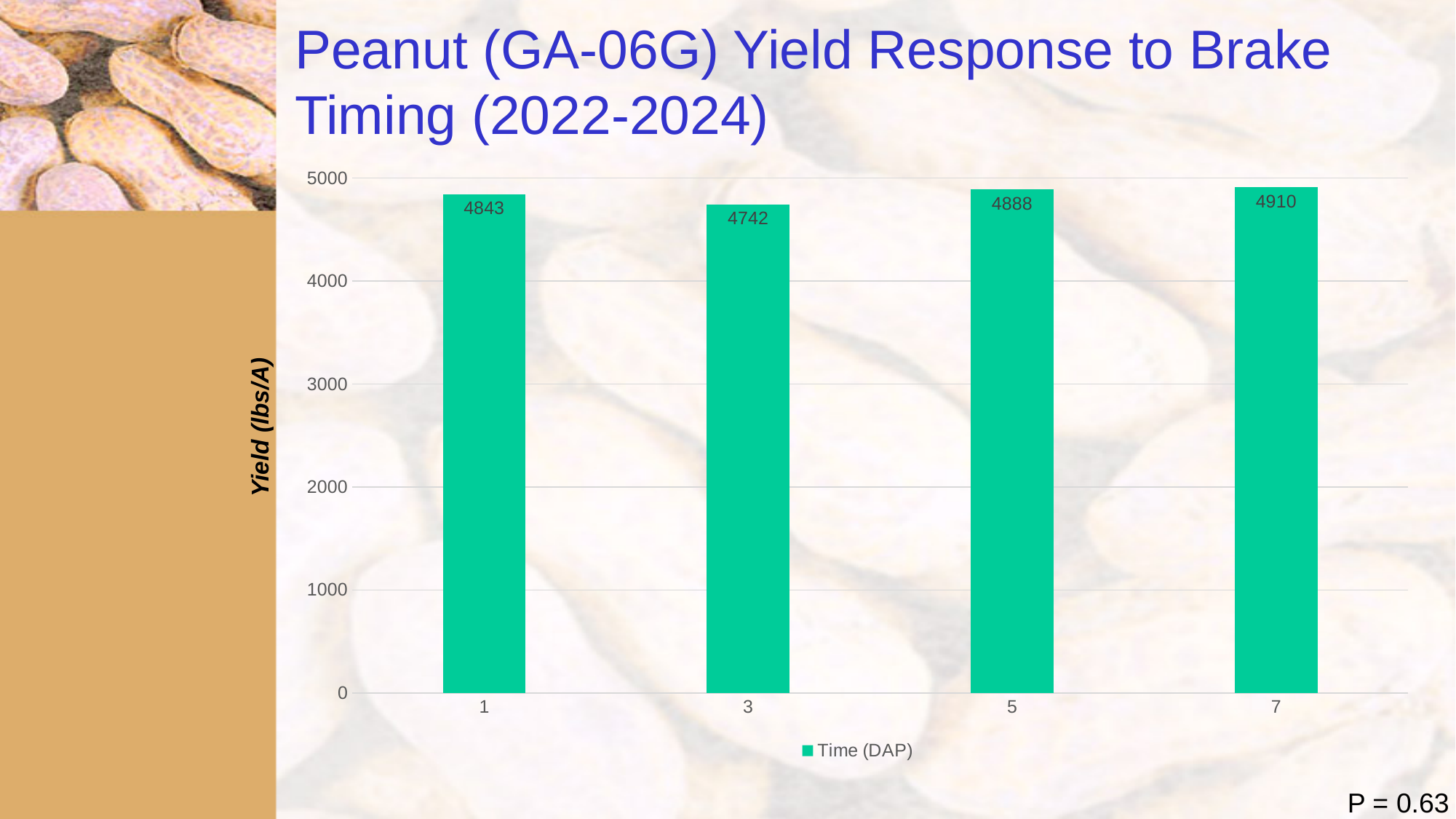
What is the yield for time 7 DAP? 4910 Is the yield for 3 DAP greater or less than 4000? greater What is the difference in yield between 7 DAP and 3 DAP? 168 What is the label of the y axis? Yield (lbs/A) What kind of chart is shown on the slide? bar chart Which has a higher yield, 1 DAP or 5 DAP? 5 DAP What is the yield for time 3 DAP? 4742 How many time (DAP) categories are shown on the chart? 4 Which time (DAP) has the highest yield? 7 What is the difference in yield between 1 DAP and 3 DAP? 101 Which time (DAP) has the lowest yield? 3 What is the yield for time 1 DAP? 4843